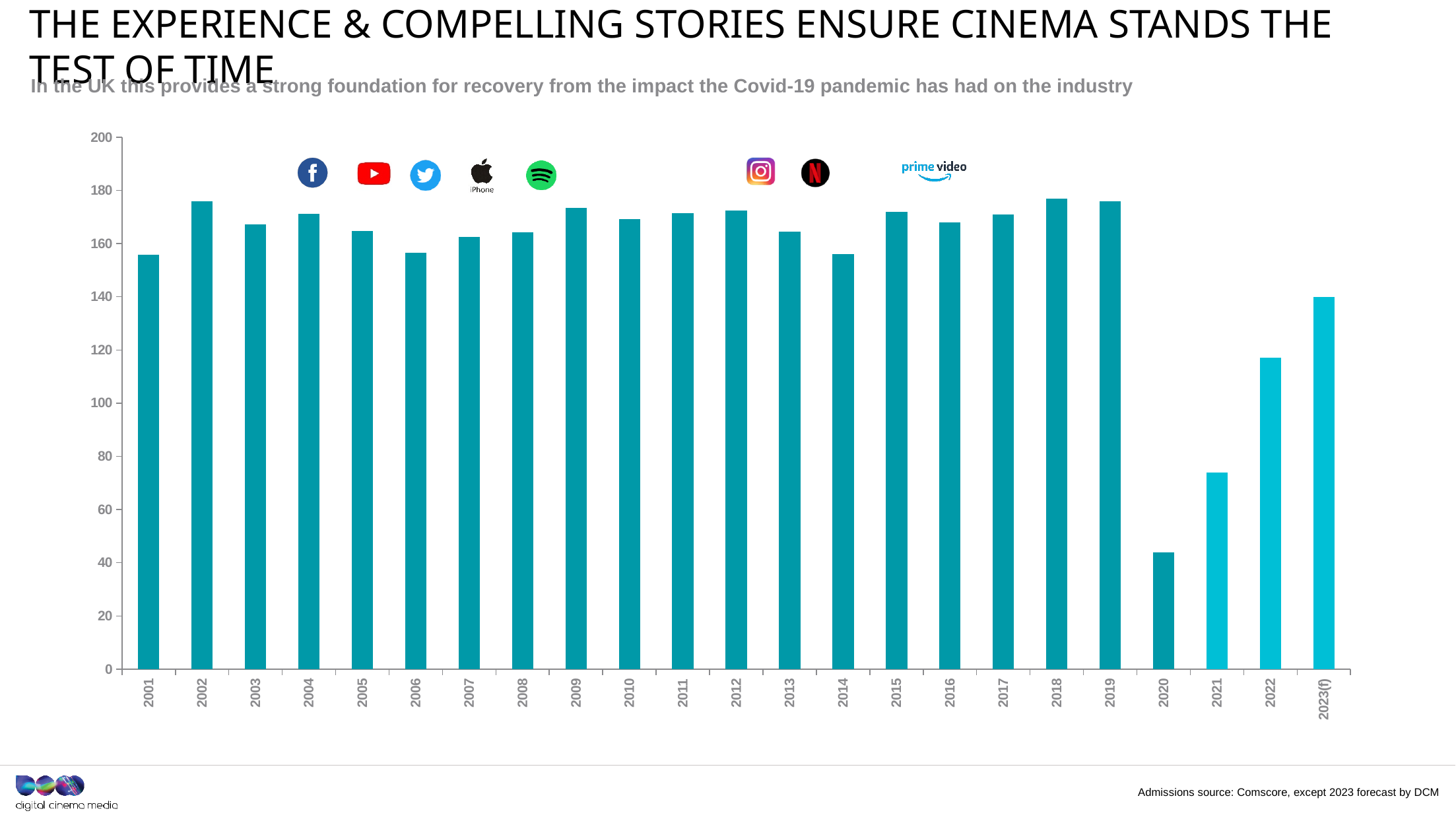
What kind of chart is shown on the slide? bar chart How many years (categories) are plotted on the x axis? 23 Which is larger, the value for 2014 or the value for 2015? 2015 Is the value for 2020 greater or less than 60? less What is the highest value shown on the y axis? 200 Do the values rise or fall from 2020 to 2023(f)? rise Is the value for 2023(f) greater or less than 120? greater Is the value for 2002 greater or less than 160? greater Which year has the lowest bar? 2020 Which is larger, the value for 2020 or the value for 2021? 2021